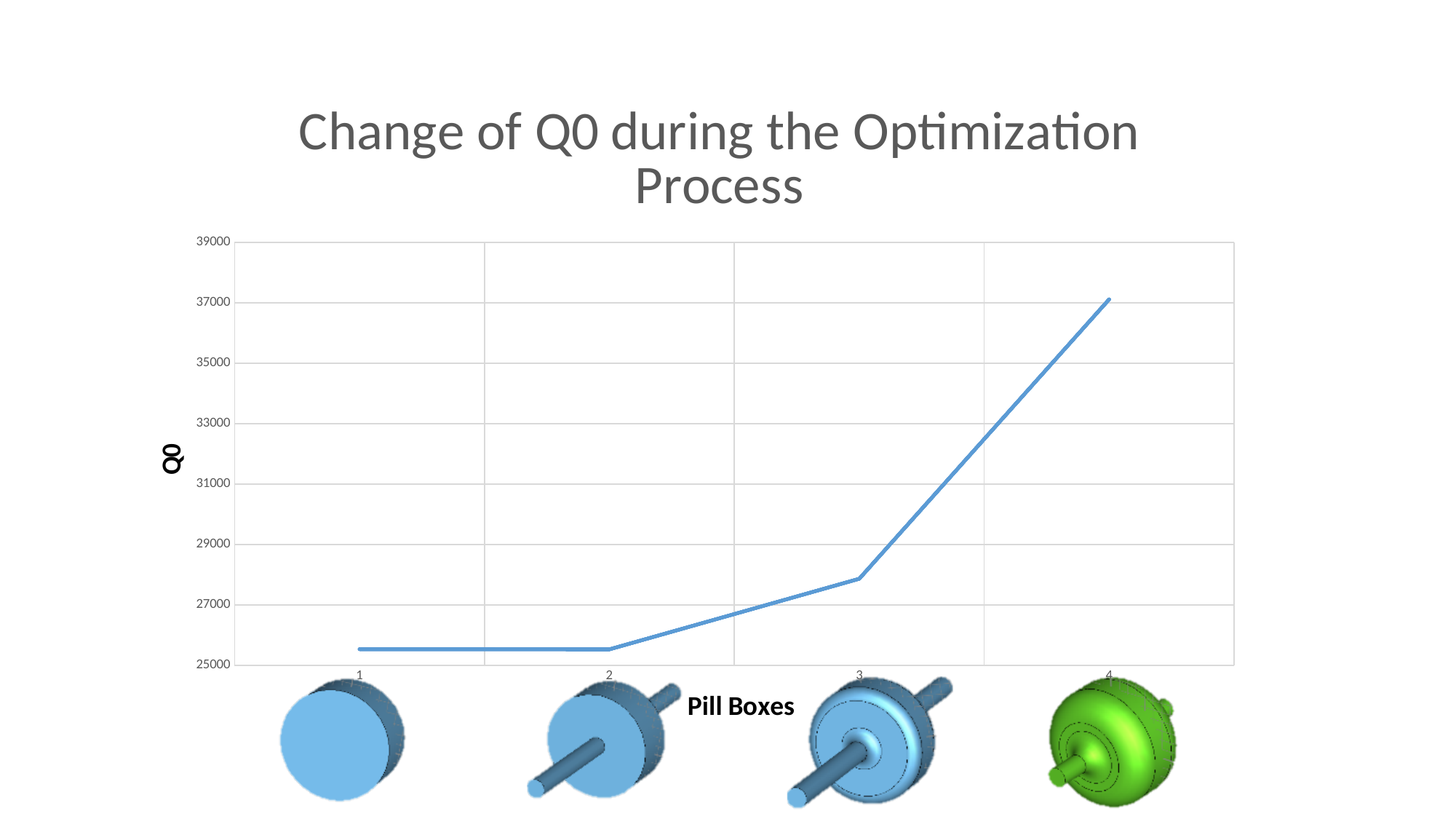
Which has a larger Q0 value, pill box 3 or pill box 4? pill box 4 What is the title of the chart? Change of Q0 during the Optimization Process Which has a larger Q0 value, pill box 2 or pill box 3? pill box 3 What kind of chart is shown on the slide? line chart Does the Q0 value rise or fall from pill box 1 to pill box 4? rise How many data points are plotted on the line? 4 Is the Q0 value for pill box 3 greater or less than 29000? less Is the Q0 value for pill box 4 greater or less than 35000? greater Is the Q0 value for pill box 3 greater or less than 27000? greater What is the label on the vertical axis of the chart? Q0 Which pill box has the highest Q0 value? 4